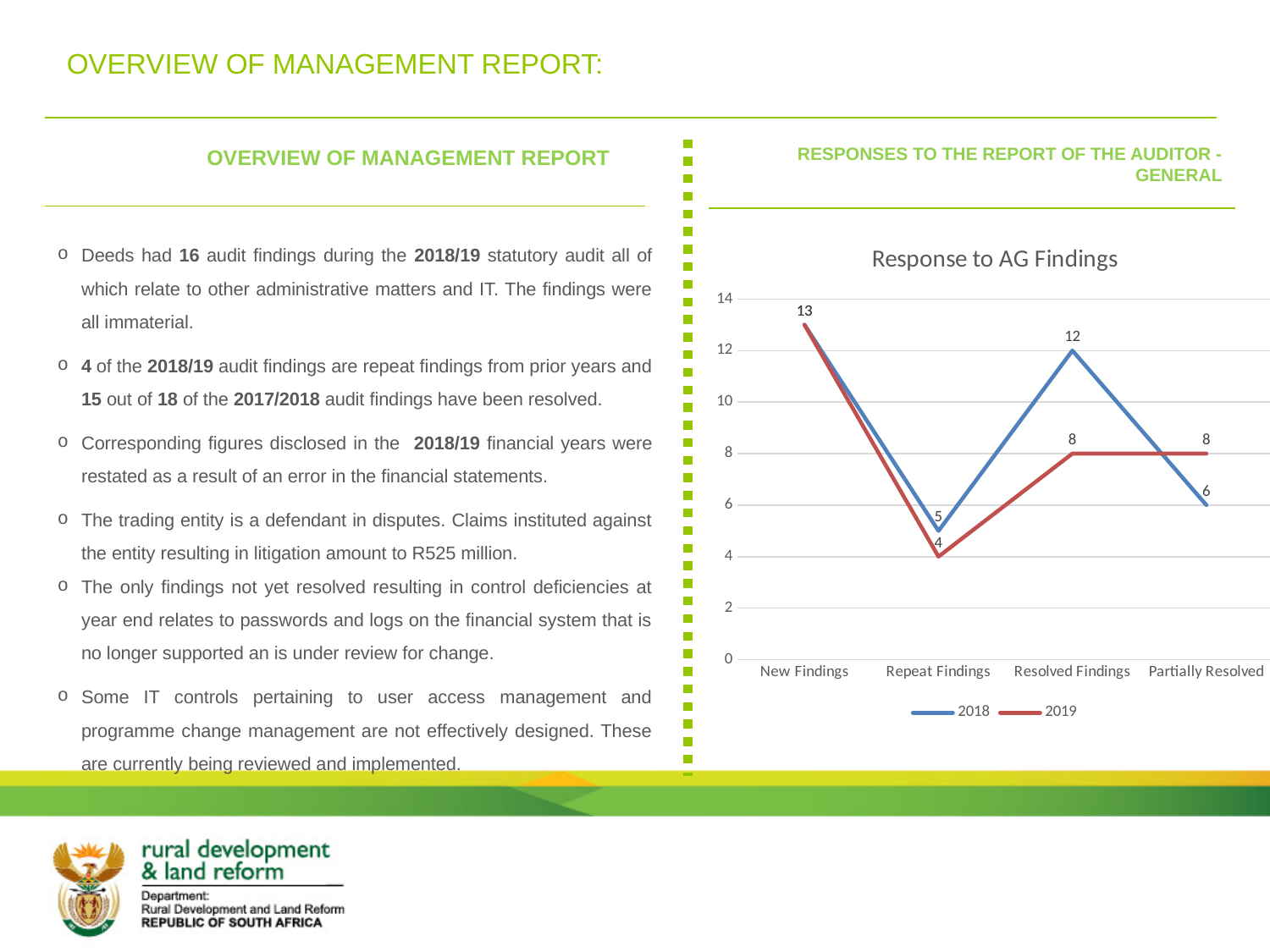
What is the 2018 value for Partially Resolved? 6 Which category has the lowest value for the 2019 series? Repeat Findings How many categories are shown on the x axis of the chart? 4 What value is labelled at New Findings? 13 How many series does the chart legend list? 2 For Repeat Findings, which series has the larger value, 2018 or 2019? 2018 What kind of chart is shown on the slide? line chart What is the difference between the 2018 and 2019 values for Resolved Findings? 4 What is the title of the chart? Response to AG Findings What is the 2018 value for Resolved Findings? 12 What is the 2019 value for Partially Resolved? 8 What is the 2019 value for Repeat Findings? 4